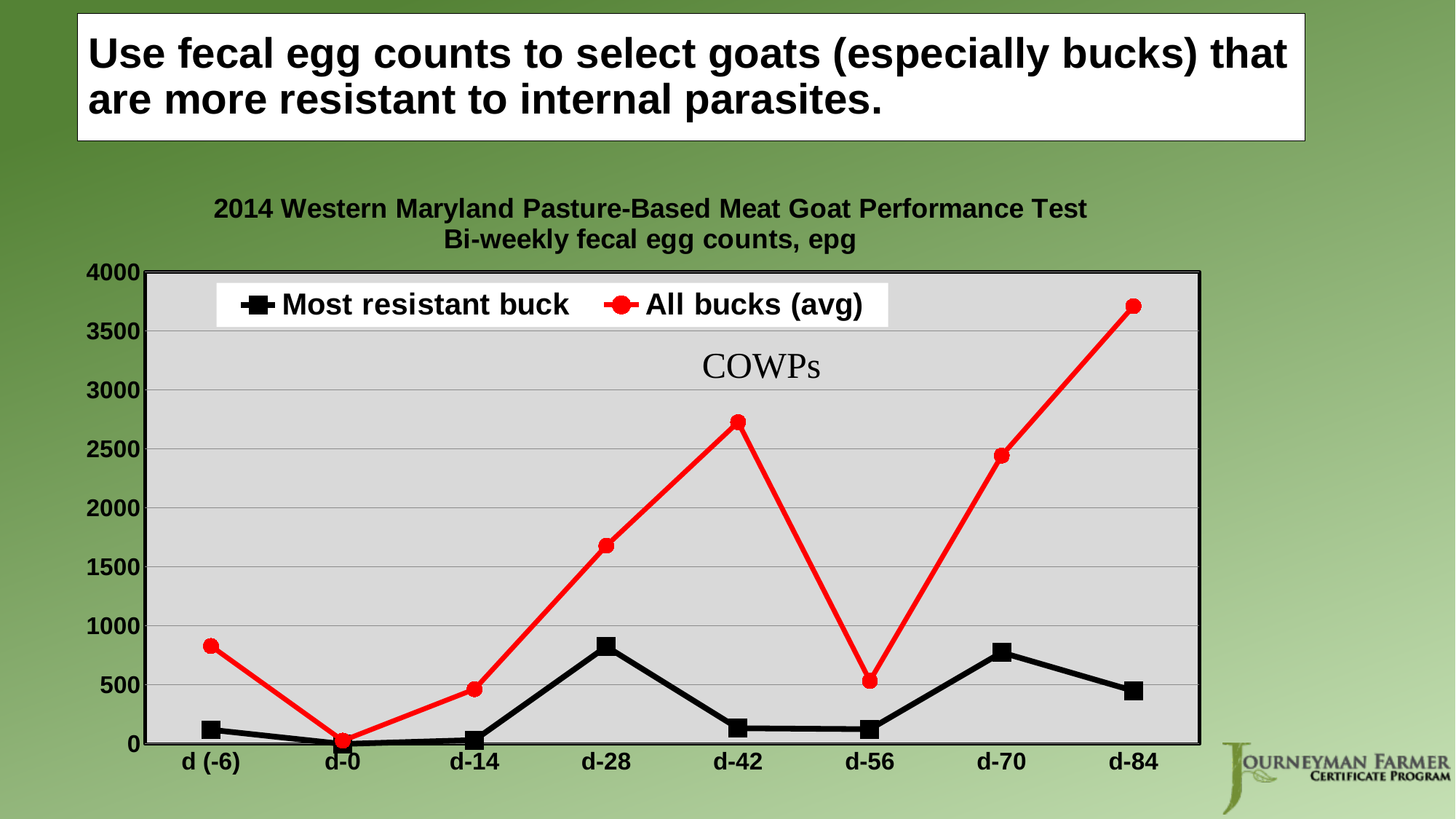
At which time point is the All bucks (avg) fecal egg count highest? d-84 Is the All bucks (avg) value at d-42 greater or less than 2500? greater Is the All bucks (avg) value at d-84 greater or less than 3500? greater What kind of chart is shown on the slide? line chart How many series does the chart legend list? 2 Is the Most resistant buck value at d-42 greater or less than 500? less At which time point is the All bucks (avg) fecal egg count lowest? d-0 Does the All bucks (avg) line rise or fall from d-56 to d-84? rise At d-28, which series has the higher fecal egg count, Most resistant buck or All bucks (avg)? All bucks (avg) How many time points are plotted along the x axis? 8 Which series is drawn with a red line and circle markers? All bucks (avg)